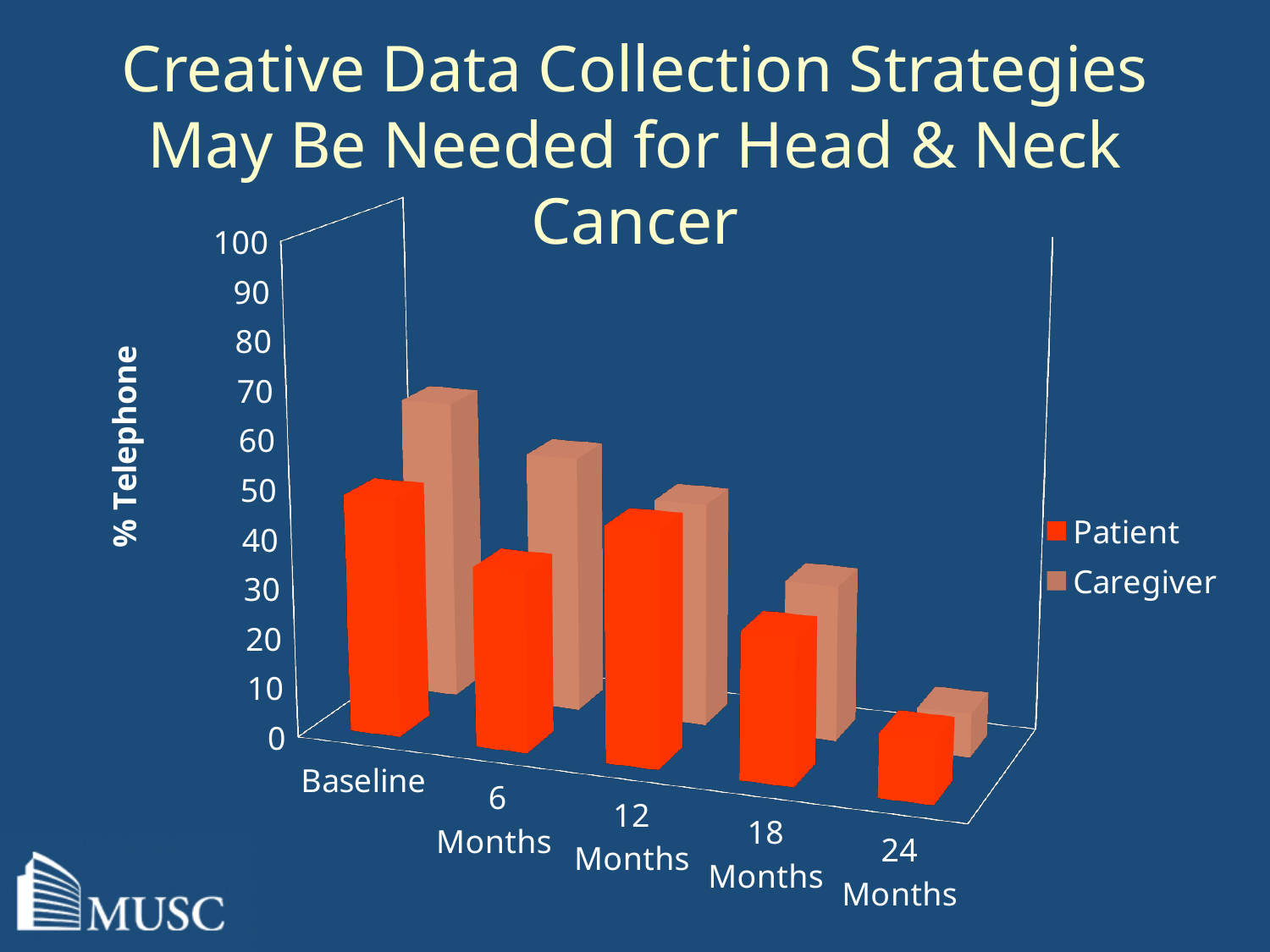
At 6 Months, which is larger: the Patient value or the Caregiver value? Caregiver Do the Caregiver values rise or fall from Baseline to 24 Months? fall At which time point is the Caregiver value lowest? 24 Months What is the label on the vertical axis? % Telephone How many series does the legend list? 2 What are the two series named in the legend? Patient and Caregiver At which time point is the Caregiver value highest? Baseline Is the Patient value at 24 Months greater or less than 30? less At Baseline, which is larger: the Patient value or the Caregiver value? Caregiver How many time-point categories are shown on the x axis? 5 At which time point is the Patient value lowest? 24 Months What kind of chart is shown on the slide? bar chart